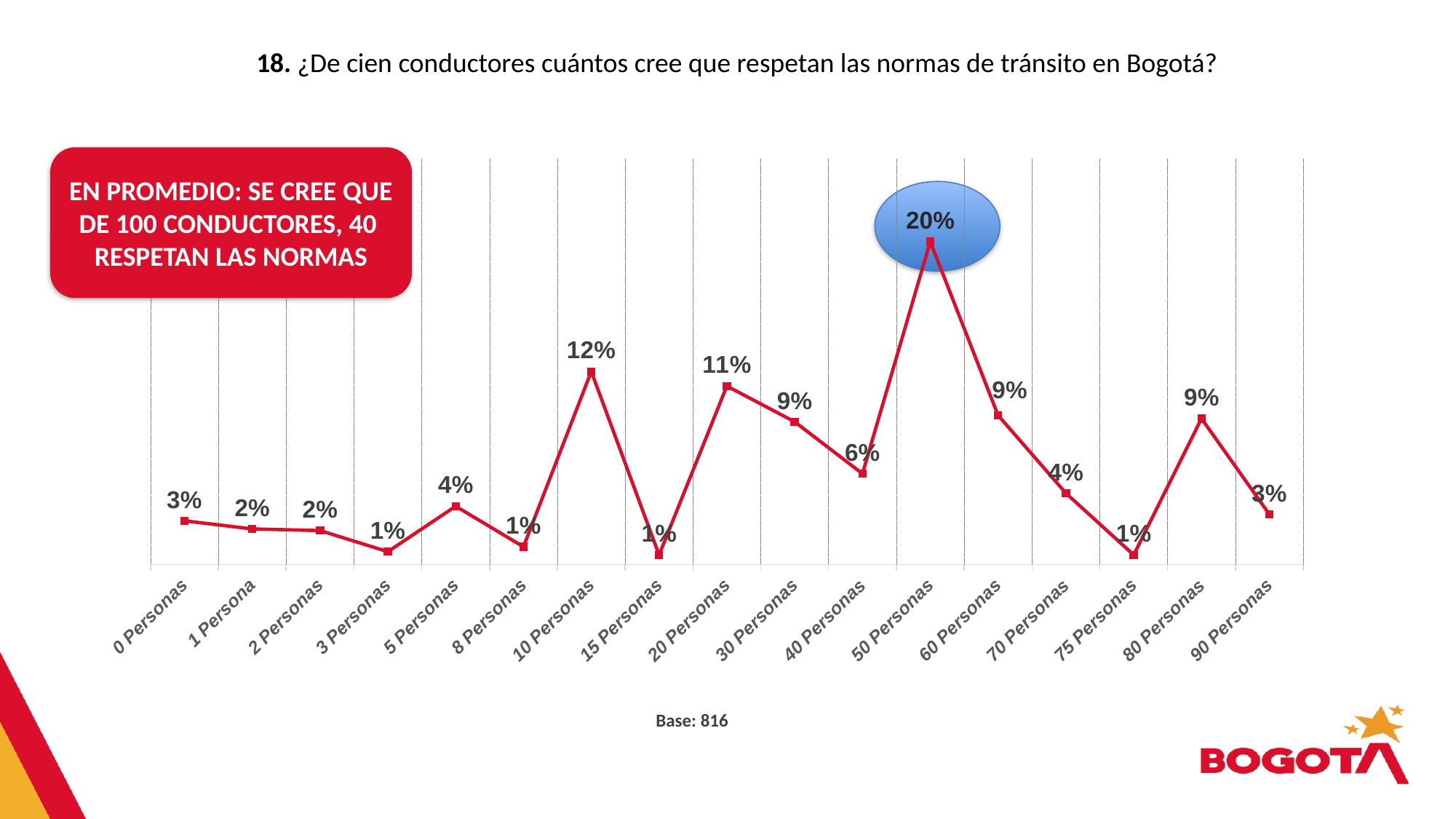
What percentage of respondents answered 50 Personas? 20% Which has a larger value, 30 Personas or 40 Personas? 30 Personas Which category has the highest value on the chart? 50 Personas Which has a larger value, 5 Personas or 8 Personas? 5 Personas What is the difference between the values for 50 Personas and 10 Personas? 8% What is the base (number of respondents) stated below the chart? 816 What is the value shown for 20 Personas? 11% How many categories are plotted on the x axis? 17 What is the value shown for 0 Personas? 3% What is the value shown for 10 Personas? 12% What is the difference between the values for 20 Personas and 40 Personas? 5% What kind of chart is shown on the slide? Line chart